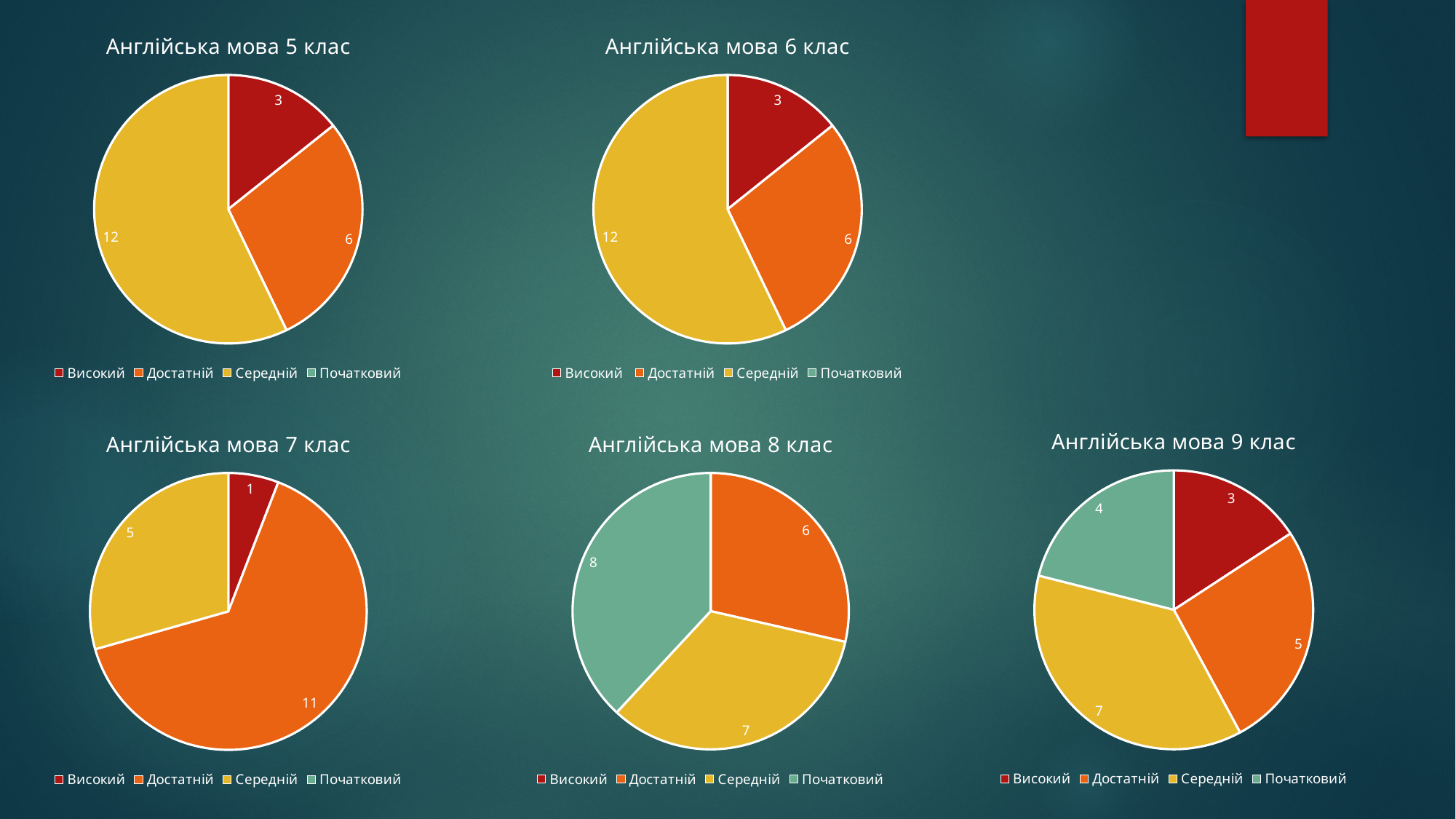
In the chart titled "Англійська мова 6 клас", what is the value for Достатній? 6 In the chart titled "Англійська мова 7 клас", which category has the lowest value? Високий In the chart titled "Англійська мова 7 клас", what is the value for Високий? 1 In the chart titled "Англійська мова 5 клас", what is the value for Середній? 12 In the chart titled "Англійська мова 9 клас", how many slices does the pie have? 4 What kind of chart is "Англійська мова 8 клас"? Pie chart In the chart titled "Англійська мова 8 клас", which is larger, the value for Достатній or the value for Середній? Середній How many charts are shown on the slide? 5 In the chart titled "Англійська мова 8 клас", what is the value for Початковий? 8 In the chart titled "Англійська мова 9 клас", which category has the highest value? Середній How many entries does the legend list under the chart titled "Англійська мова 5 клас"? 4 In the chart titled "Англійська мова 9 клас", what is the difference between the values for Середній and Початковий? 3